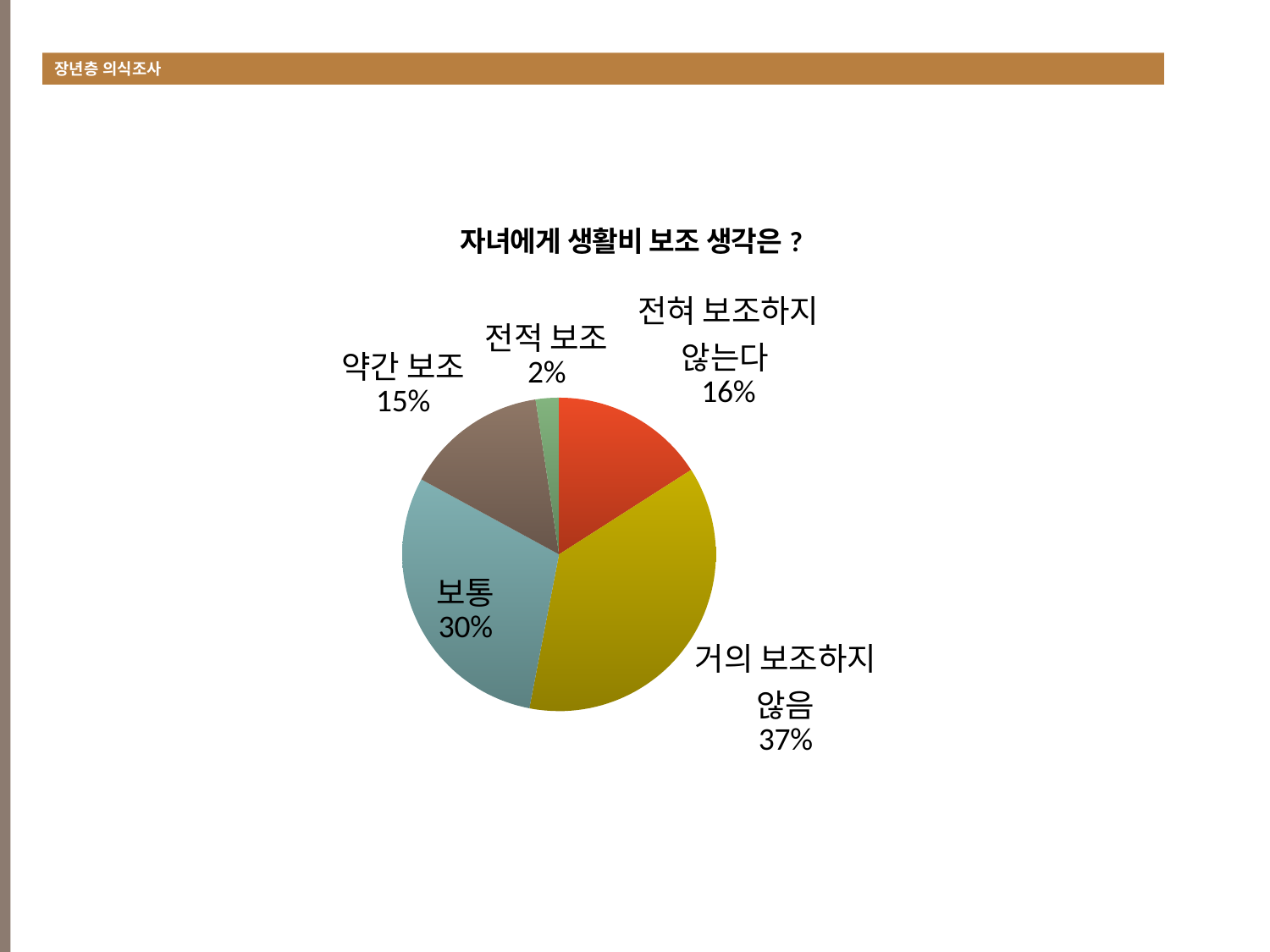
What is the title of the chart? 자녀에게 생활비 보조 생각은 ? What is the value shown for 약간 보조? 15% What is the value shown for 보통? 30% What share of the pie does 거의 보조하지 않음 represent? 37% What kind of chart is shown on the slide? Pie chart What is the difference between the values for 거의 보조하지 않음 and 보통? 7% What is the value shown for 전혀 보조하지 않는다? 16% Which category has the largest slice of the pie? 거의 보조하지 않음 Which category has the smallest slice of the pie? 전적 보조 How many categories are shown in the pie chart? 5 What is the value shown for 전적 보조? 2% Which is larger, the value for 보통 or the value for 전혀 보조하지 않는다? 보통